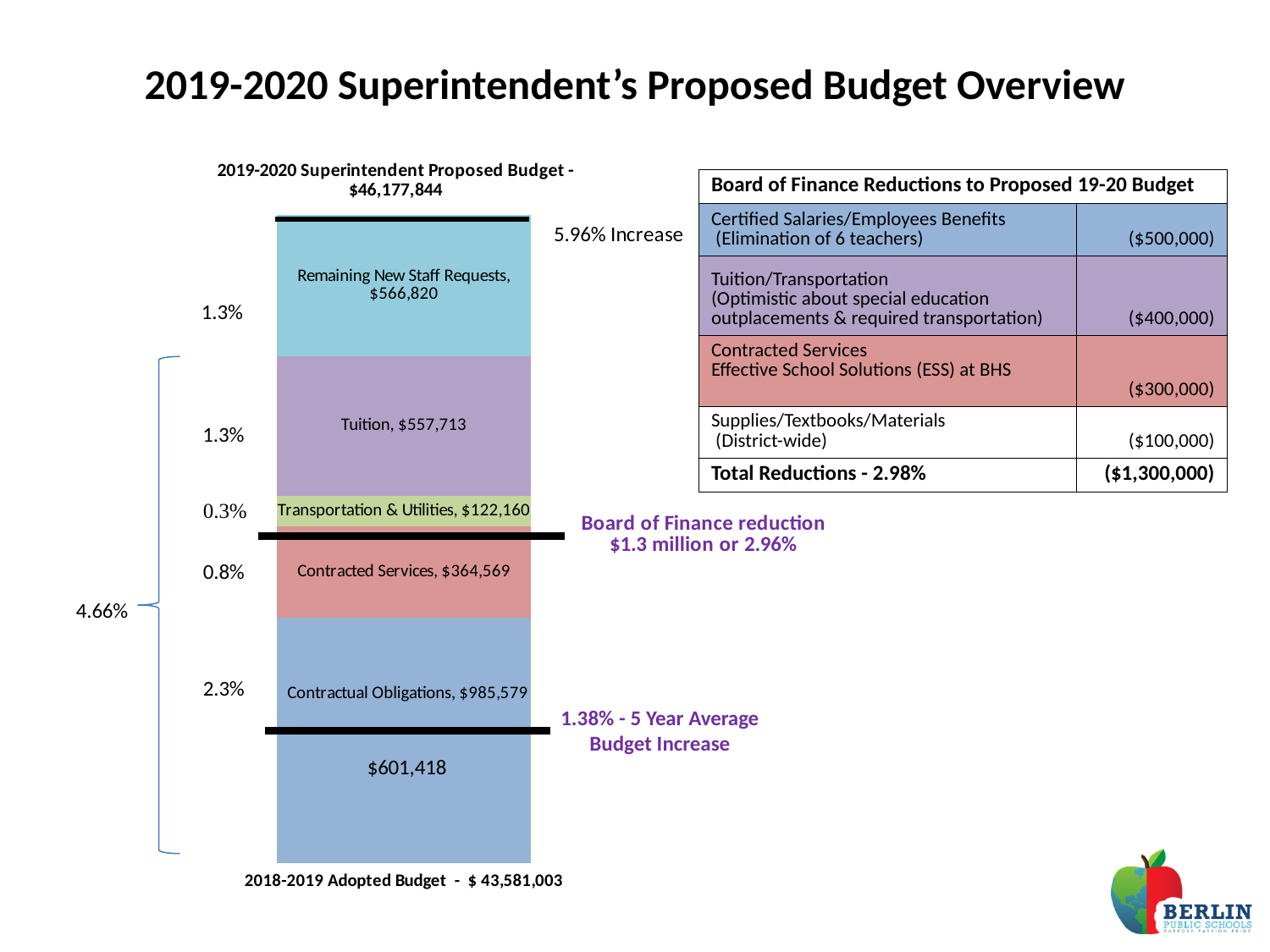
Which is larger, the Tuition segment or the Contracted Services segment? Tuition What is the value of the Contracted Services segment in the stacked bar? $364,569 Which named segment of the stacked bar has the smallest value? Transportation & Utilities What percentage is shown to the left of the Contractual Obligations segment? 2.3% What is the value of the Tuition segment in the stacked bar? $557,713 What is the difference between the Contractual Obligations segment and the Contracted Services segment? $621,010 What is the title of the chart? 2019-2020 Superintendent Proposed Budget - $46,177,844 How many segments make up the stacked bar? 5 What is the value of the Remaining New Staff Requests segment? $566,820 What kind of chart is shown on the slide? Stacked bar chart What is the value of the Transportation & Utilities segment? $122,160 Which named segment of the stacked bar has the largest value? Contractual Obligations